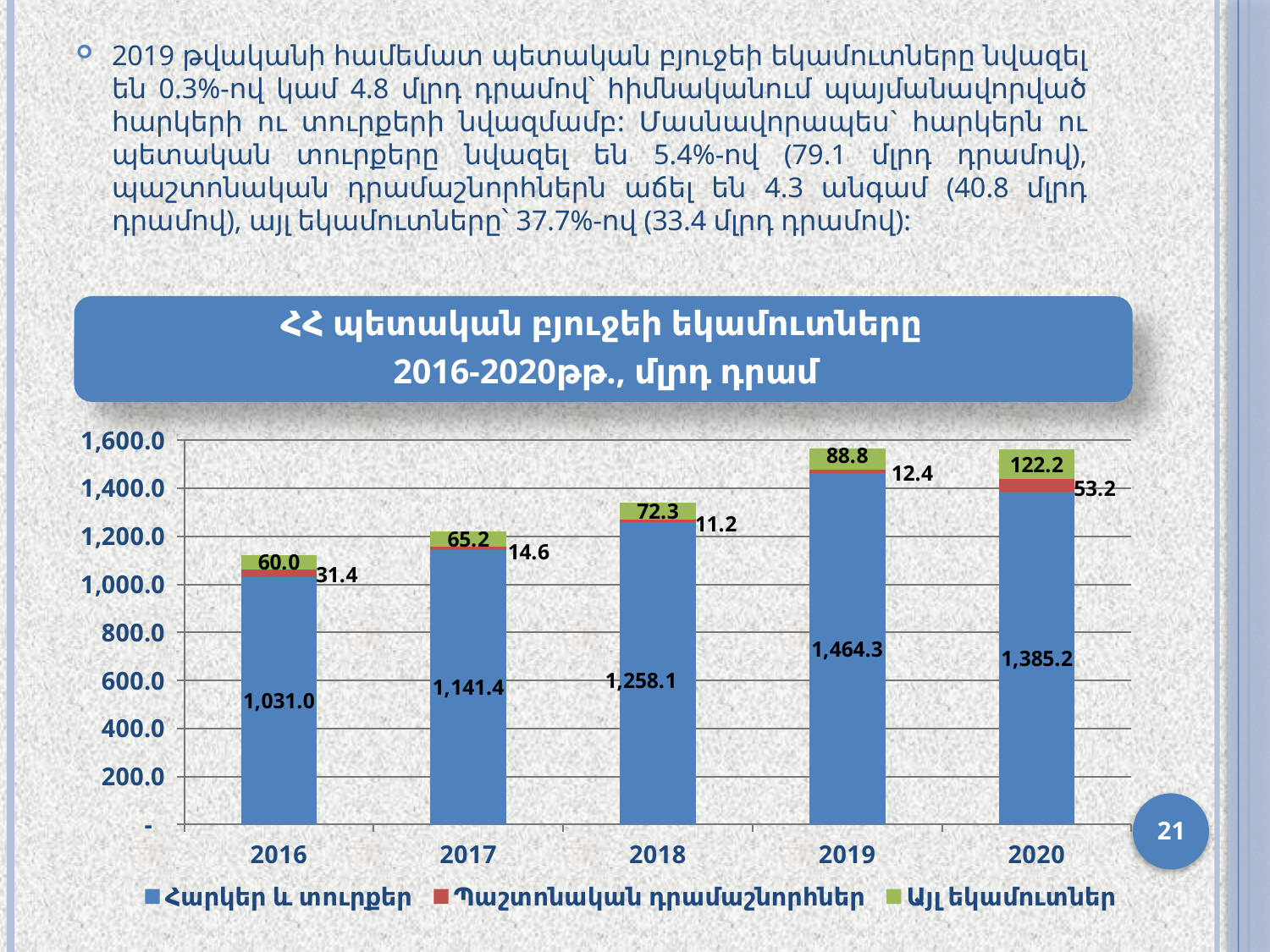
Does Հարկեր և տուրքեր rise or fall from 2016 to 2019? rise What is the difference between Հարկեր և տուրքեր in 2019 and in 2020? 79.1 What type of chart is shown on the slide? stacked bar chart In which year is Պաշտոնական դրամաշնորհներ lowest? 2018 What is the value of Այլ եկամուտներ for 2020? 122.2 In which year is Հարկեր և տուրքեր highest? 2019 How many years are shown on the x axis? 5 What is the value of Հարկեր և տուրքեր for 2019? 1,464.3 Which is larger: Այլ եկամուտներ in 2017 or in 2018? 2018 What is the value of Պաշտոնական դրամաշնորհներ for 2018? 11.2 What is the total of the stacked bar for 2016? 1,122.4 How many series does the legend list? 3